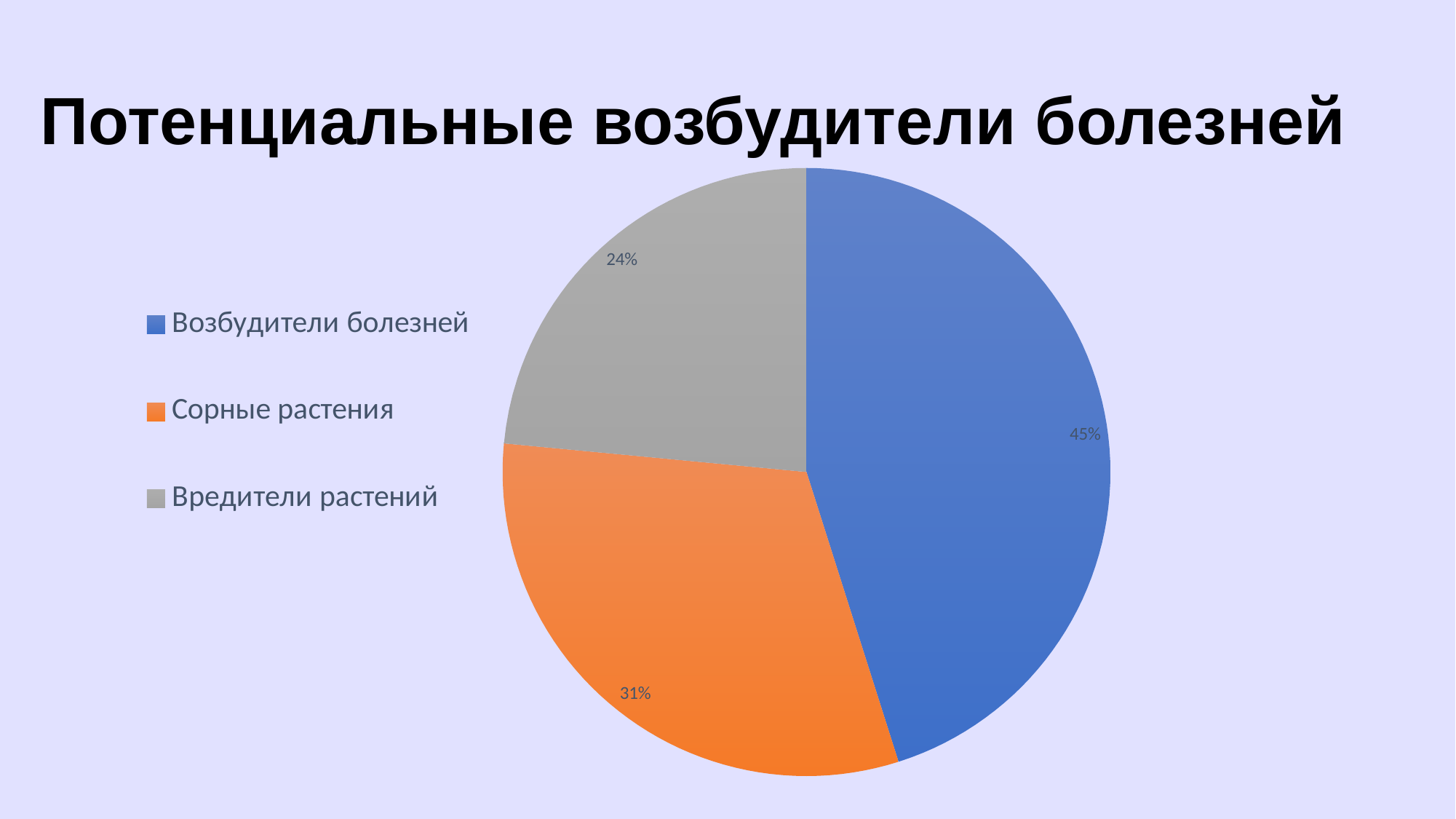
How many categories are shown in the pie chart? 3 What is the title of the slide? Потенциальные возбудители болезней What share of the pie does Сорные растения have? 31% Which is larger, the slice for Сорные растения or the slice for Вредители растений? Сорные растения What share of the pie does Вредители растений have? 24% Which category has the smallest slice of the pie? Вредители растений What is the difference in percentage points between Возбудители болезней and Сорные растения? 14 What is the difference in percentage points between Сорные растения and Вредители растений? 7 What colour is the slice for Сорные растения? Orange What kind of chart is shown on the slide? Pie chart What share of the pie does Возбудители болезней have? 45% Which category has the largest slice of the pie? Возбудители болезней